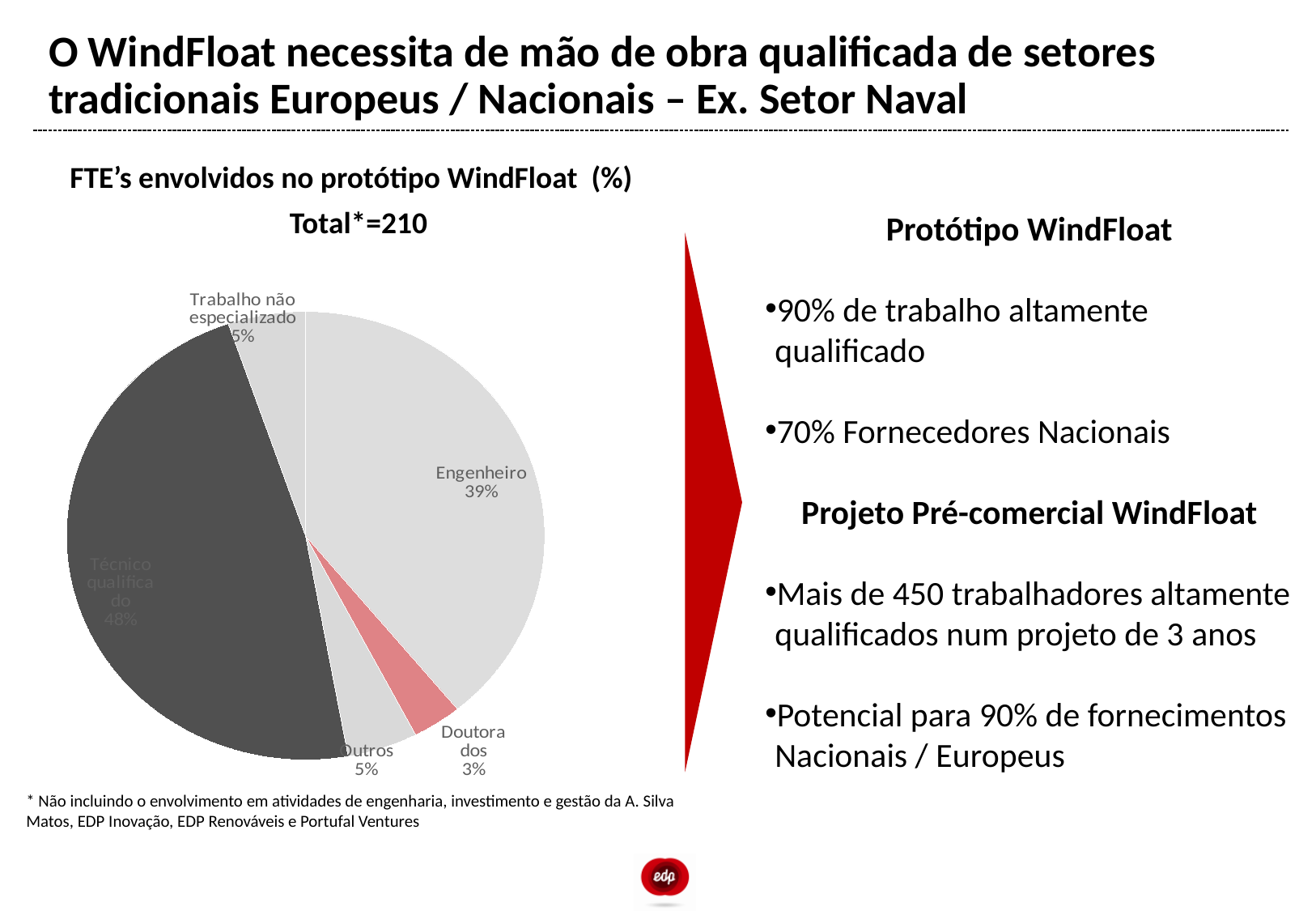
What kind of chart is shown on the slide? pie chart What percentage of FTEs are Engenheiro? 39% Which category has the largest share of the pie? Técnico qualificado What percentage of FTEs are Técnico qualificado? 48% What is the title of the chart? FTE's envolvidos no protótipo WindFloat (%) Which category has the smallest share of the pie? Doutorados How many categories does the pie chart show? 5 Which is larger, the share for Engenheiro or the share for Outros? Engenheiro What is the difference in percentage points between Técnico qualificado and Engenheiro? 9 What percentage of FTEs are Doutorados? 3% What total is stated above the pie chart? 210 What percentage of FTEs are Trabalho não especializado? 5%